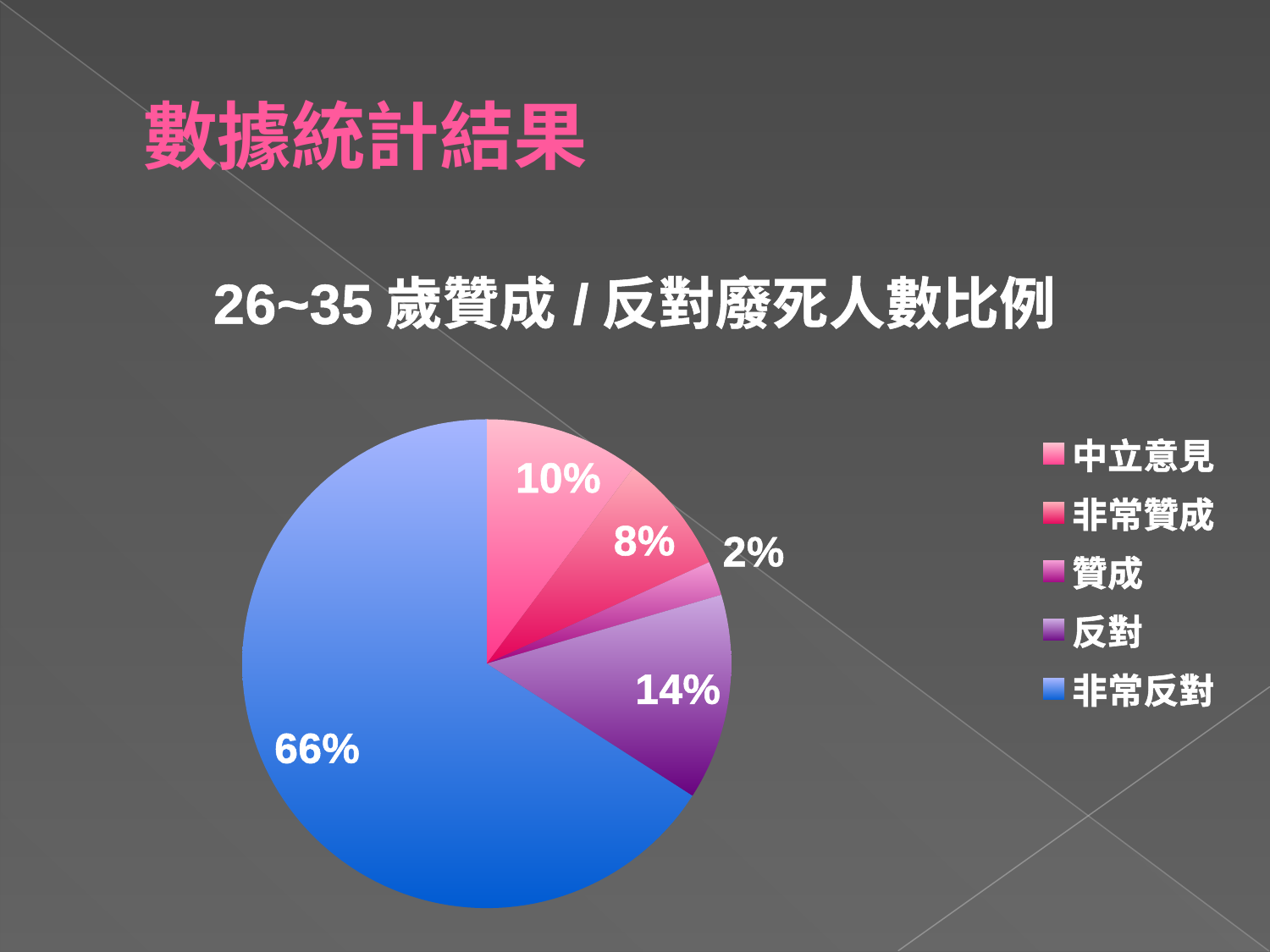
How many categories does the legend list? 5 Which category has the smallest share of the pie? 贊成 What share of the pie is 反對? 14% What kind of chart is shown on the slide? pie chart Which category has the largest share of the pie? 非常反對 What share of the pie is 非常反對? 66% What share of the pie is 非常贊成? 8% What is the difference between the shares of 反對 and 中立意見? 4% What is the title of the chart? 26~35 歲贊成 / 反對廢死人數比例 Which is larger, the share of 非常贊成 or the share of 反對? 反對